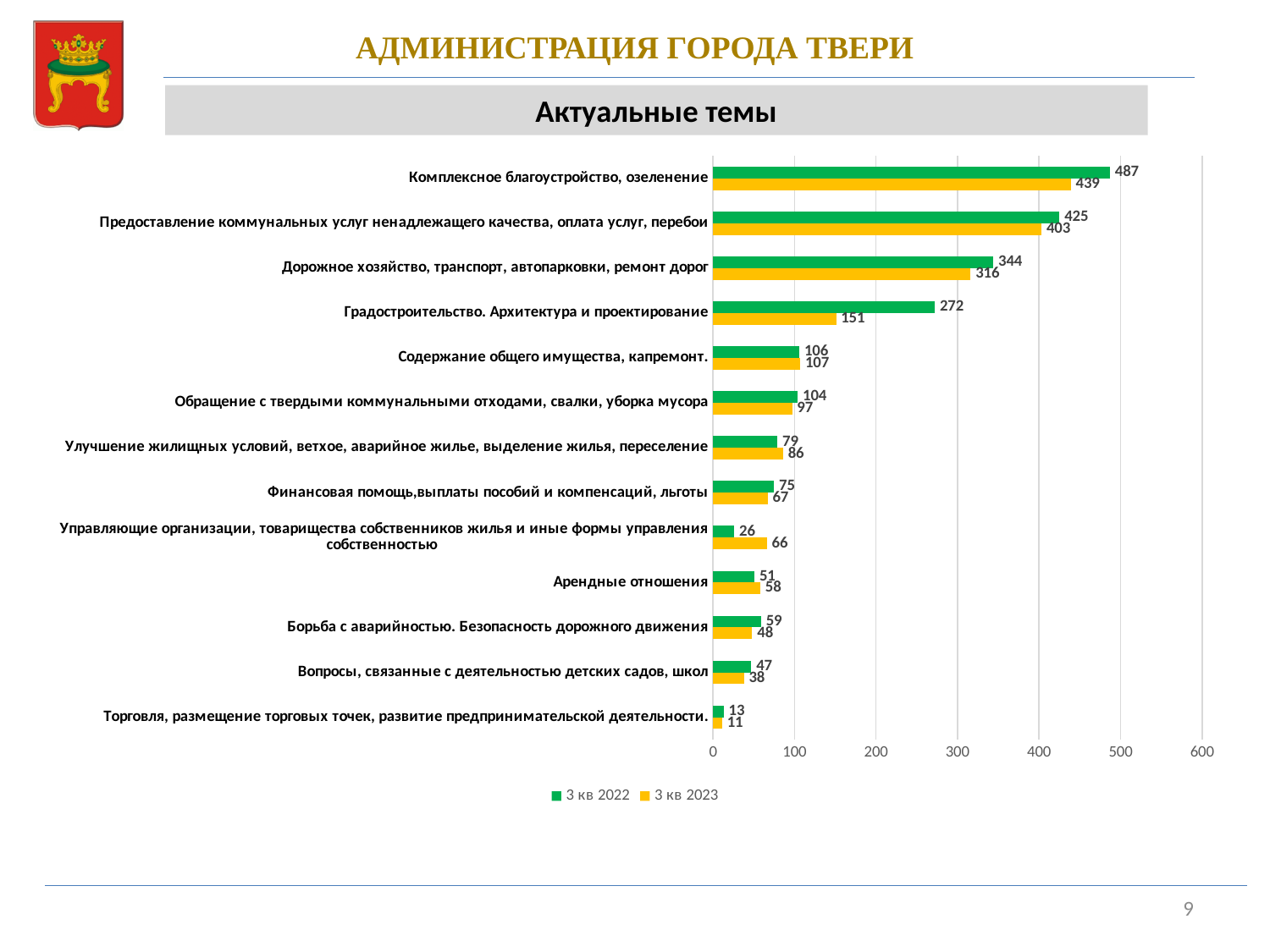
What is the value for "Комплексное благоустройство, озеленение" in the "3 кв 2022" series? 487 What is the value for "Градостроительство. Архитектура и проектирование" in the "3 кв 2023" series? 151 What is the value for "Управляющие организации, товарищества собственников жилья и иные формы управления собственностью" in the "3 кв 2022" series? 26 How many series does the legend list? 2 What is the difference between the "3 кв 2022" and "3 кв 2023" values for "Градостроительство. Архитектура и проектирование"? 121 What type of chart is shown on the slide? bar chart Which category has the lowest value in the "3 кв 2022" series? Торговля, размещение торговых точек, развитие предпринимательской деятельности. Is the "3 кв 2023" value for "Предоставление коммунальных услуг ненадлежащего качества, оплата услуг, перебои" greater or less than 400? greater For "Дорожное хозяйство, транспорт, автопарковки, ремонт дорог", which series has the larger value, "3 кв 2022" or "3 кв 2023"? 3 кв 2022 Which category has the highest value in the "3 кв 2023" series? Комплексное благоустройство, озеленение What is the title of the chart? Актуальные темы How many categories are shown on the chart? 13